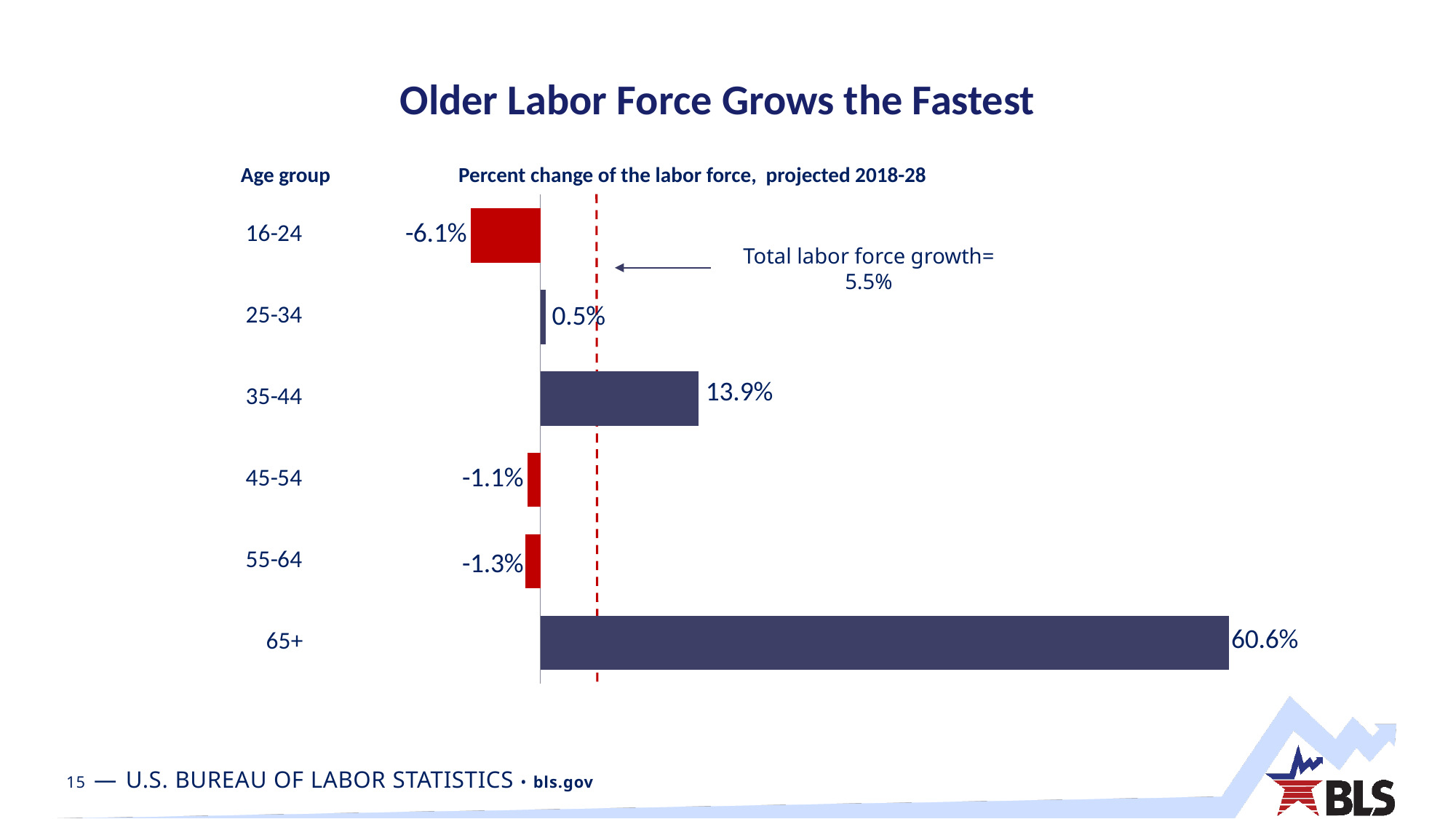
What is the projected percent change of the labor force for the 65+ age group? 60.6% What is the difference between the projected percent change for the 65+ age group and the 35-44 age group? 46.7 percentage points Which age group has the highest projected percent change of the labor force? 65+ Which age group has a larger projected percent change, 25-34 or 35-44? 35-44 What is the projected percent change of the labor force for the 55-64 age group? -1.3% What total labor force growth value does the dashed red line represent? 5.5% Which age group has the lowest projected percent change of the labor force? 16-24 What is the projected percent change of the labor force for the 35-44 age group? 13.9% What is the projected percent change of the labor force for the 16-24 age group? -6.1% How many age groups are shown in the chart? 6 What kind of chart is shown on the slide? Bar chart What is the title of the slide? Older Labor Force Grows the Fastest